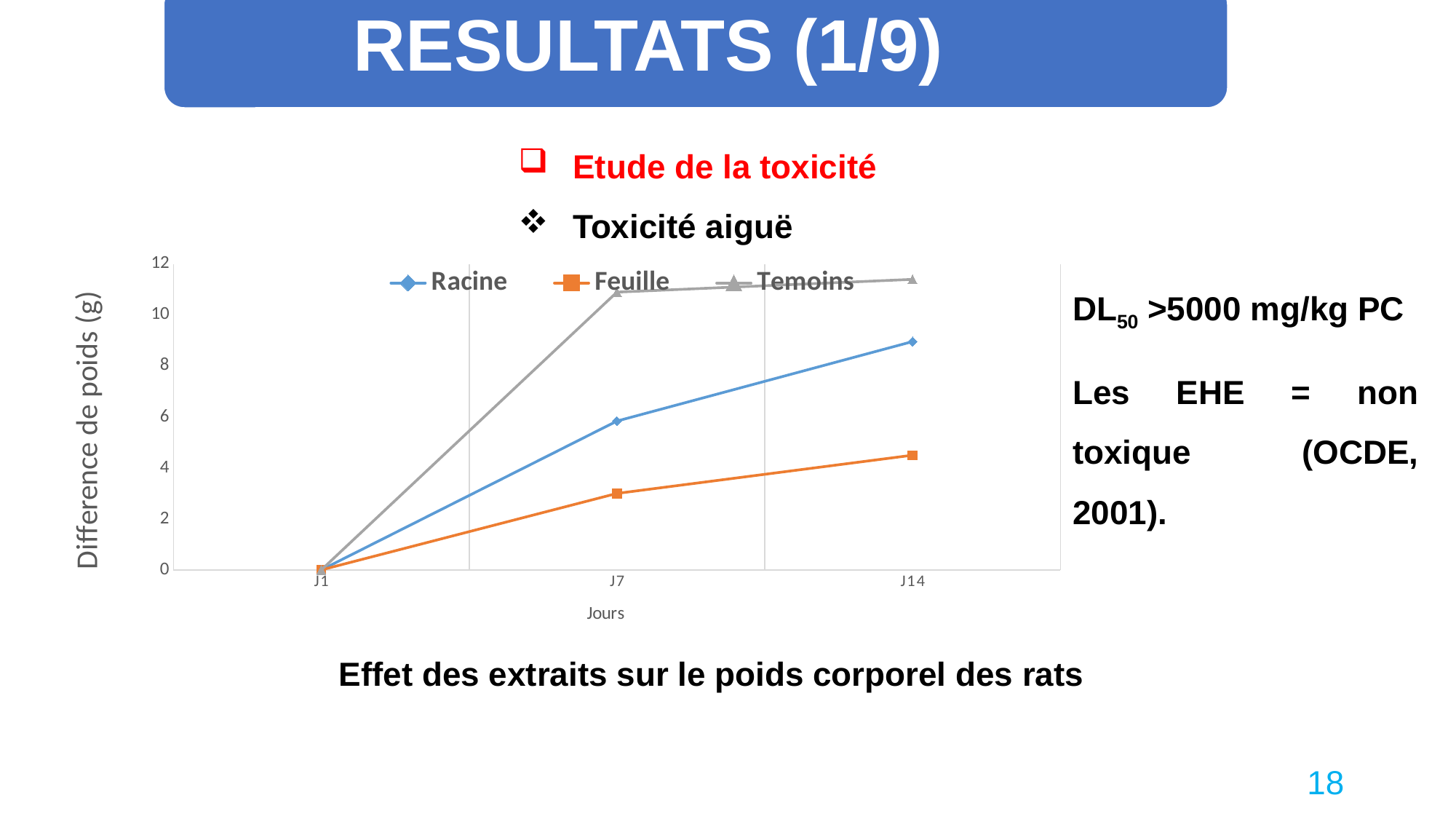
How many points are plotted along the x axis (Jours)? 3 Is the value for Racine at J14 greater or less than 8? greater Is the value for Temoins at J7 greater or less than 10? greater What kind of chart is shown on the slide? line chart Which series has the lowest value at J14? Feuille What is the value for Feuille at J1? 0 At J7, which is larger: the value for Racine or the value for Feuille? Racine Which series has the highest value at J14? Temoins What is the title of the y axis? Difference de poids (g) Do the values for Racine rise or fall from J1 to J14? rise How many series does the legend list? 3 Is the value for Feuille at J14 greater or less than 6? less